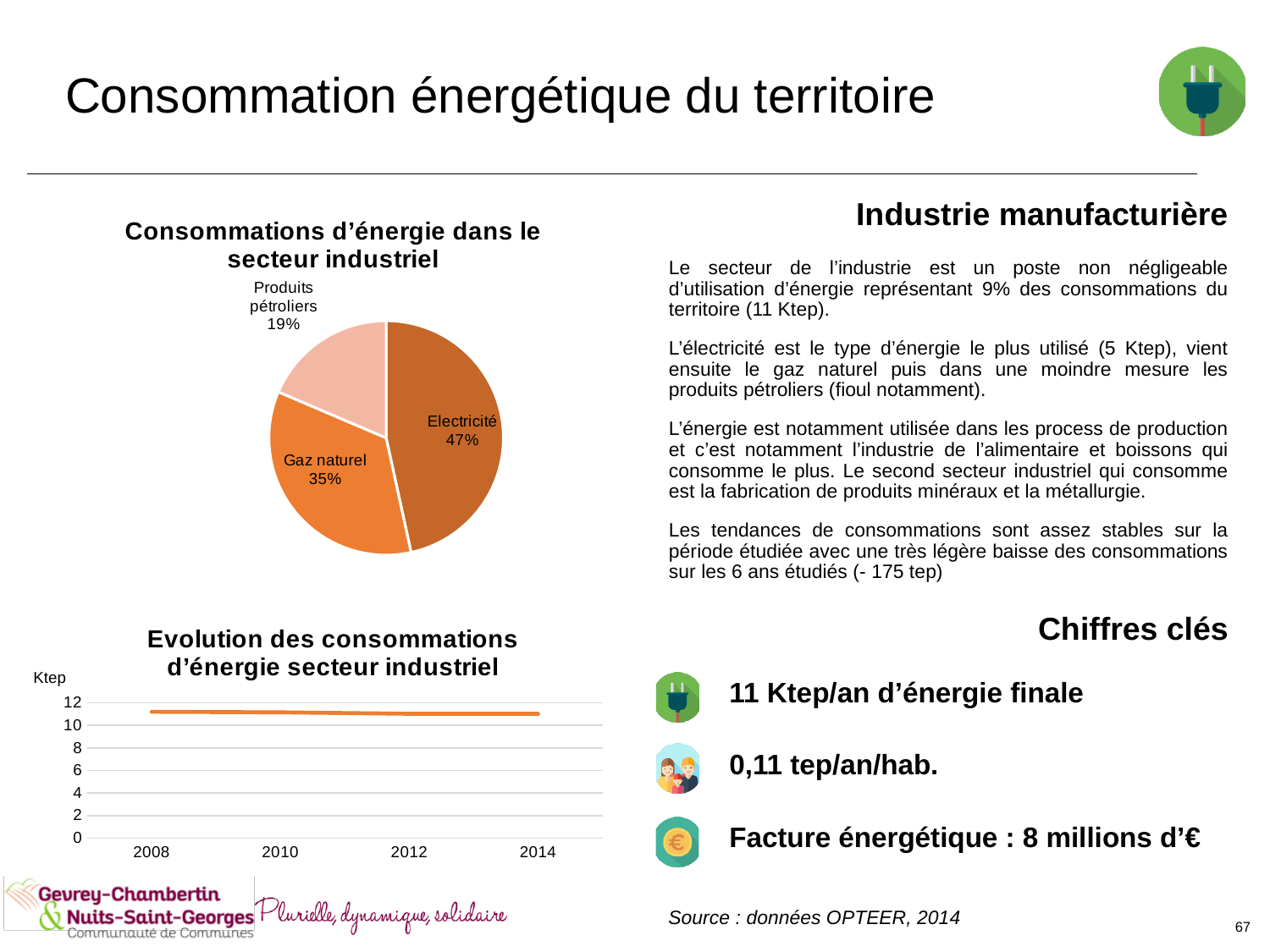
What kind of chart is 'Evolution des consommations d'énergie secteur industriel'? Line chart In the pie chart 'Consommations d'énergie dans le secteur industriel', what share does Electricité have? 47% In the pie chart 'Consommations d'énergie dans le secteur industriel', what share does Gaz naturel have? 35% How many slices does the pie chart 'Consommations d'énergie dans le secteur industriel' have? 3 In the pie chart 'Consommations d'énergie dans le secteur industriel', which energy type has the largest share? Electricité In the chart 'Evolution des consommations d'énergie secteur industriel', is the value for 2008 greater or less than 10? greater In the pie chart 'Consommations d'énergie dans le secteur industriel', what is the difference in percentage points between Electricité and Gaz naturel? 12 percentage points In the chart 'Evolution des consommations d'énergie secteur industriel', is the value for 2014 greater or less than 12? less In the pie chart 'Consommations d'énergie dans le secteur industriel', which energy type has the smallest share? Produits pétroliers In the pie chart 'Consommations d'énergie dans le secteur industriel', which is larger: Gaz naturel or Produits pétroliers? Gaz naturel What unit is shown on the vertical axis of the chart 'Evolution des consommations d'énergie secteur industriel'? Ktep In the pie chart 'Consommations d'énergie dans le secteur industriel', what share do Produits pétroliers have? 19%